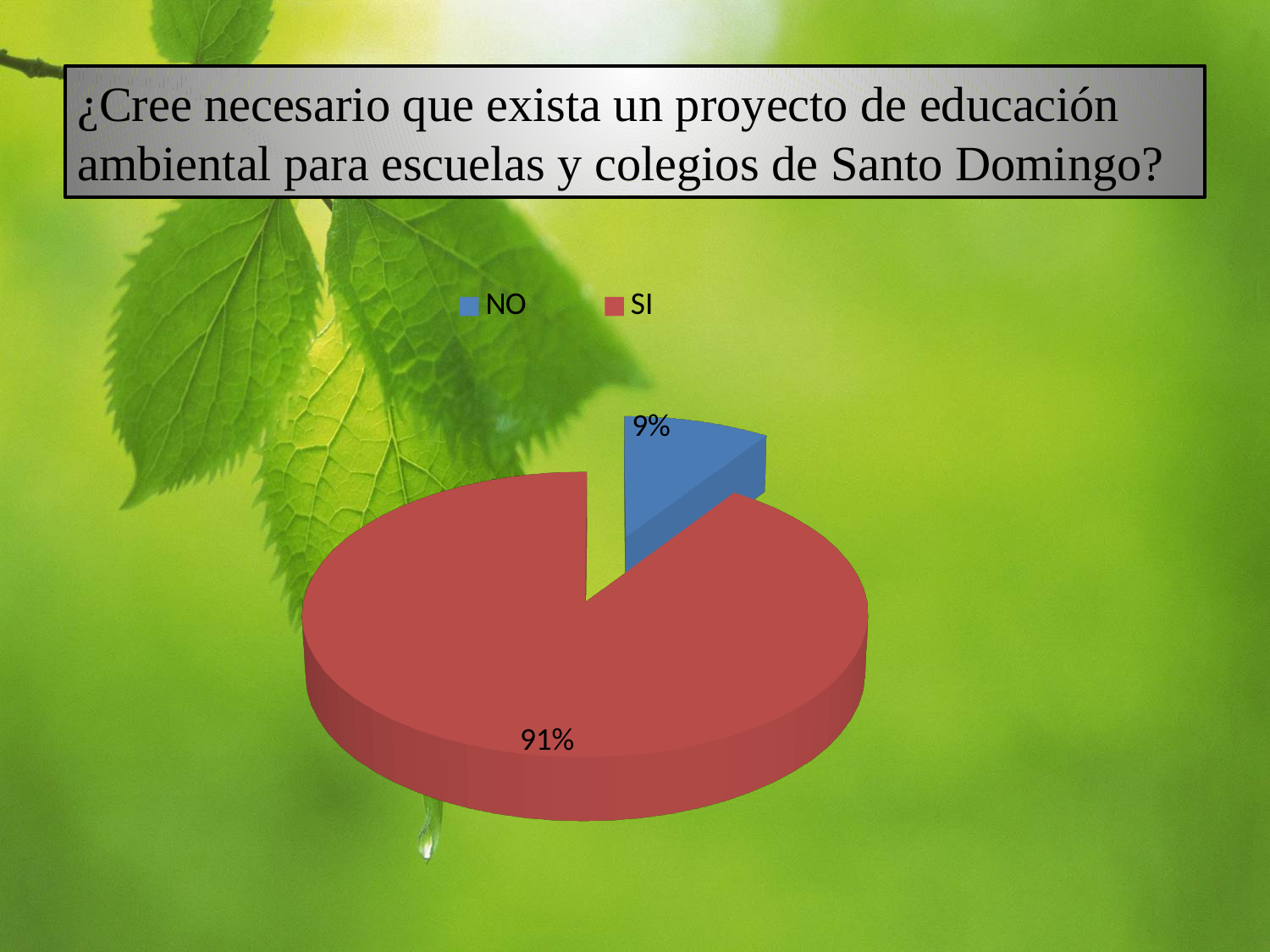
How many entries does the legend list? 2 What share of the pie does the NO slice represent? 9% What kind of chart is shown on the slide? pie chart Which category has the largest slice of the pie? SI What colour is the SI slice of the pie? red Which is larger, the SI slice or the NO slice? SI How many categories does the pie chart show? 2 What share of the pie does the SI slice represent? 91% What is the difference in percentage points between the SI and NO slices? 82 What colour is the NO slice of the pie? blue Which category has the smallest slice of the pie? NO